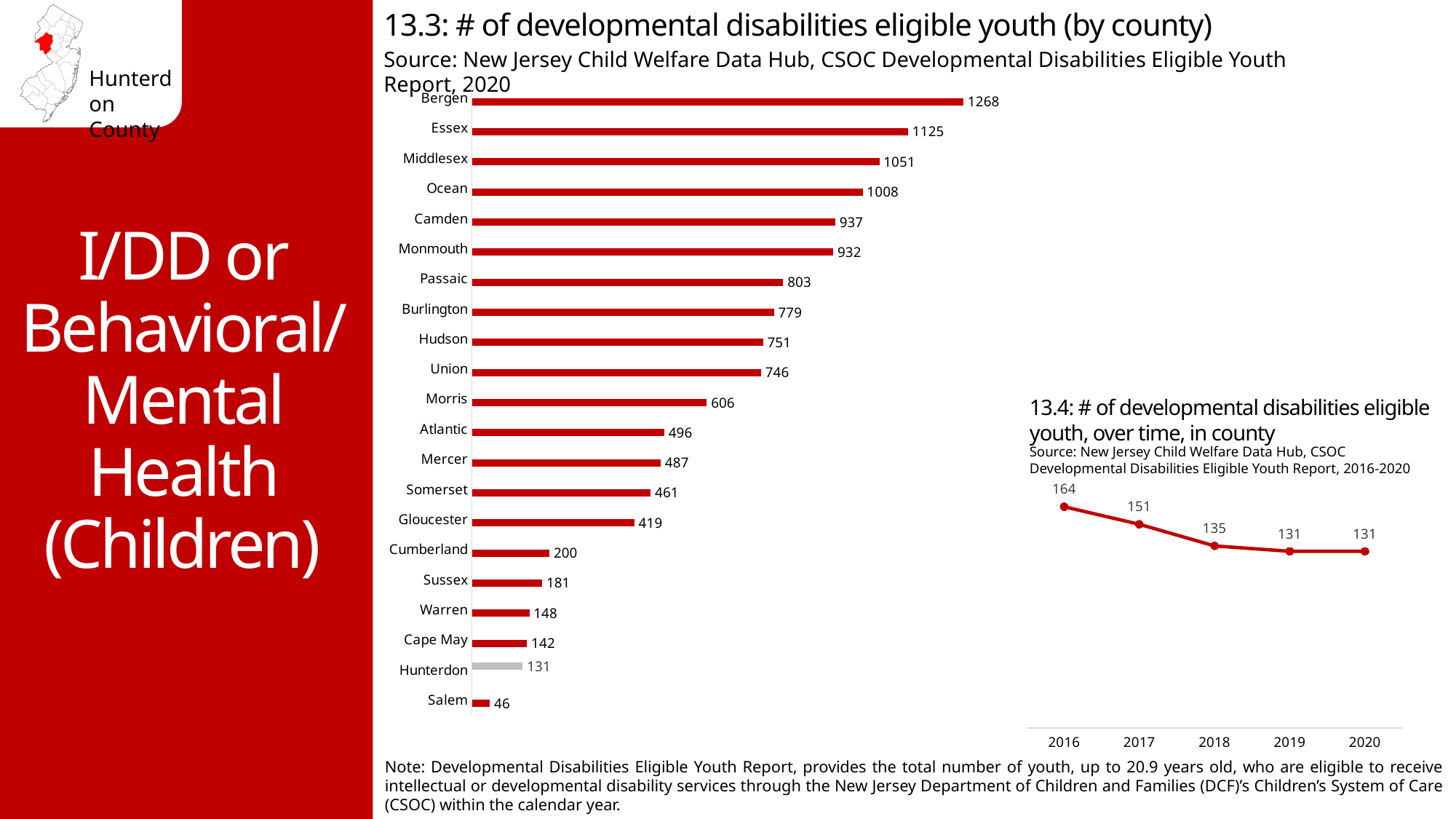
In chart 13.3 (by county), what is the value for Hunterdon? 131 In chart 13.3 (# of developmental disabilities eligible youth by county), what is the value for Bergen? 1268 In chart 13.4 (over time, in county), what is the difference between 2016 and 2020? 33 In chart 13.3 (by county), which county has the highest value? Bergen In chart 13.4 (over time, in county), what is the value for 2016? 164 In chart 13.3 (by county), which county has the lowest value? Salem In chart 13.3 (by county), which bar is shown in a different colour (grey) from the others? Hunterdon In chart 13.3 (by county), what is the difference between Essex and Middlesex? 74 What kind of chart is chart 13.3 (by county)? Bar chart In chart 13.3 (by county), how many counties are shown? 21 In chart 13.4 (over time, in county), do the values rise or fall from 2016 to 2020? Fall In chart 13.3 (by county), which is larger, Camden or Monmouth? Camden